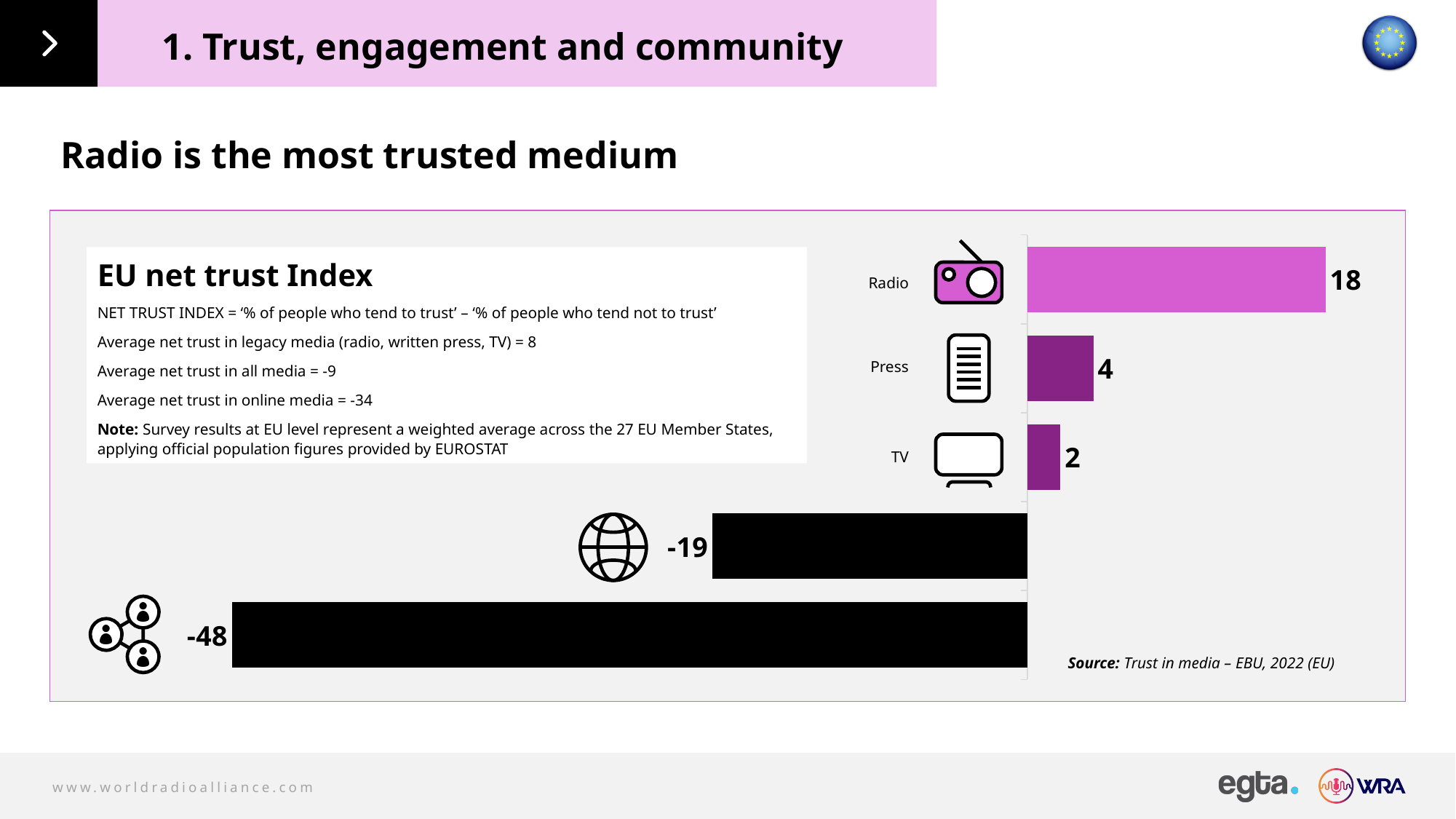
How many bars are plotted on the chart? 5 What is the lowest value shown on the chart? -48 What is the EU net trust Index value for TV? 2 Which has a higher net trust index, Press or TV? Press What is the title of the chart? EU net trust Index What is the EU net trust Index value for Press? 4 Which labelled medium has the highest net trust index on the chart? Radio What kind of chart is shown on the slide? Bar chart What is the difference between the net trust index for Press and for TV? 2 What is the EU net trust Index value for Radio? 18 What is the difference between the net trust index for Radio and for Press? 14 How many bars on the chart have negative values? 2